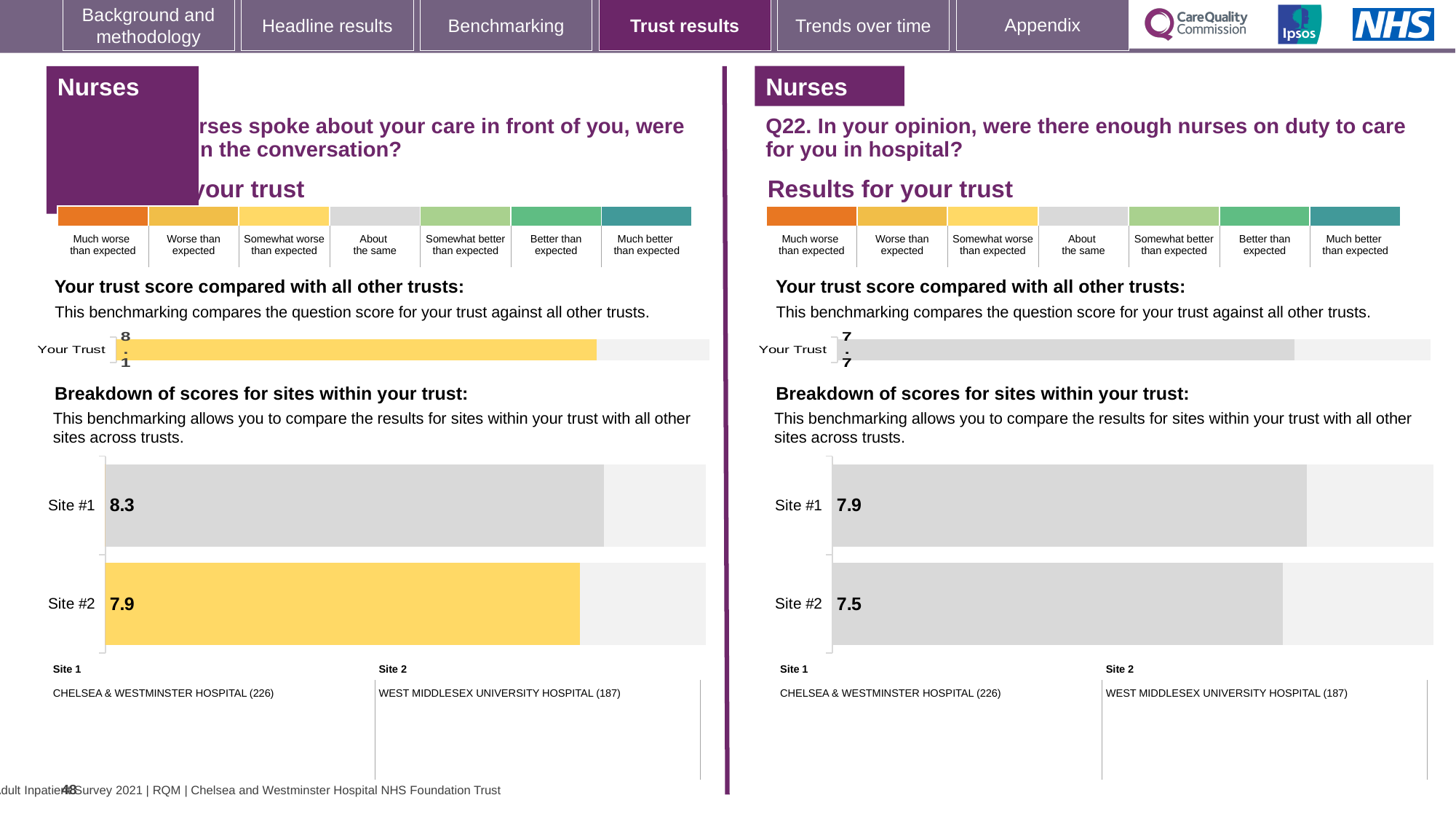
On the left half of the slide, what is the score shown for Site #1 in the breakdown of scores for sites chart? 8.3 On the right half of the slide (Q22), which site has the higher score in the breakdown of scores for sites chart? Site #1 What kind of chart is used for the breakdown of scores for sites on the left half of the slide? Bar chart On the right half of the slide (Q22), what is the score shown for Site #2 in the breakdown of scores for sites chart? 7.5 On the left half of the slide, which site has the lower score in the breakdown of scores for sites chart? Site #2 On the left half of the slide, what is the 'Your Trust' score in the trust score comparison chart? 8.1 On the right half of the slide (Q22), what is the difference between the Site #1 and Site #2 scores in the breakdown chart? 0.4 On the right half of the slide (Q22), what is the score shown for Site #1 in the breakdown of scores for sites chart? 7.9 How many sites are shown in the breakdown of scores for sites chart on the right half of the slide (Q22)? 2 On the left half of the slide, what is the difference between the Site #1 and Site #2 scores in the breakdown chart? 0.4 On the right half of the slide (Q22), what is the 'Your Trust' score in the trust score comparison chart? 7.7 On the left half of the slide, what is the score shown for Site #2 in the breakdown of scores for sites chart? 7.9